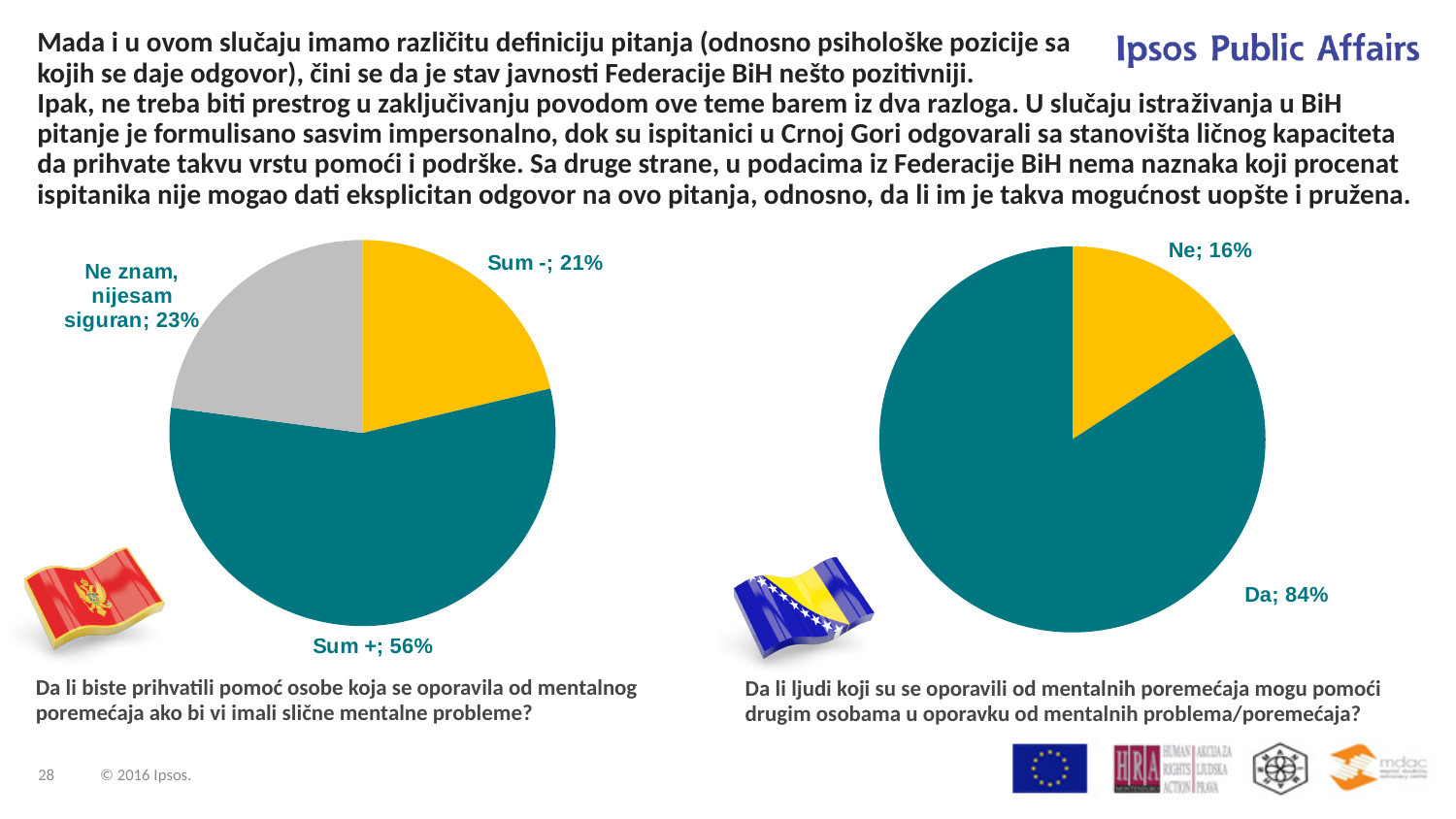
In the left pie chart, which category has the smallest share? Sum - In the left pie chart, what is the value for "Sum +"? 56% In the right pie chart, what is the value for "Da"? 84% In the left pie chart, what is the value for "Sum -"? 21% What type of chart is the right chart on the slide? Pie chart In the left pie chart, what is the value for "Ne znam, nijesam siguran"? 23% In the right pie chart, what is the difference between "Da" and "Ne"? 68% In the left pie chart, which category has the largest share? Sum + In the left pie chart, what is the difference between "Sum +" and "Sum -"? 35% How many slices does the left pie chart have? 3 In the right pie chart, what is the value for "Ne"? 16% In the right pie chart, which is larger, "Da" or "Ne"? Da